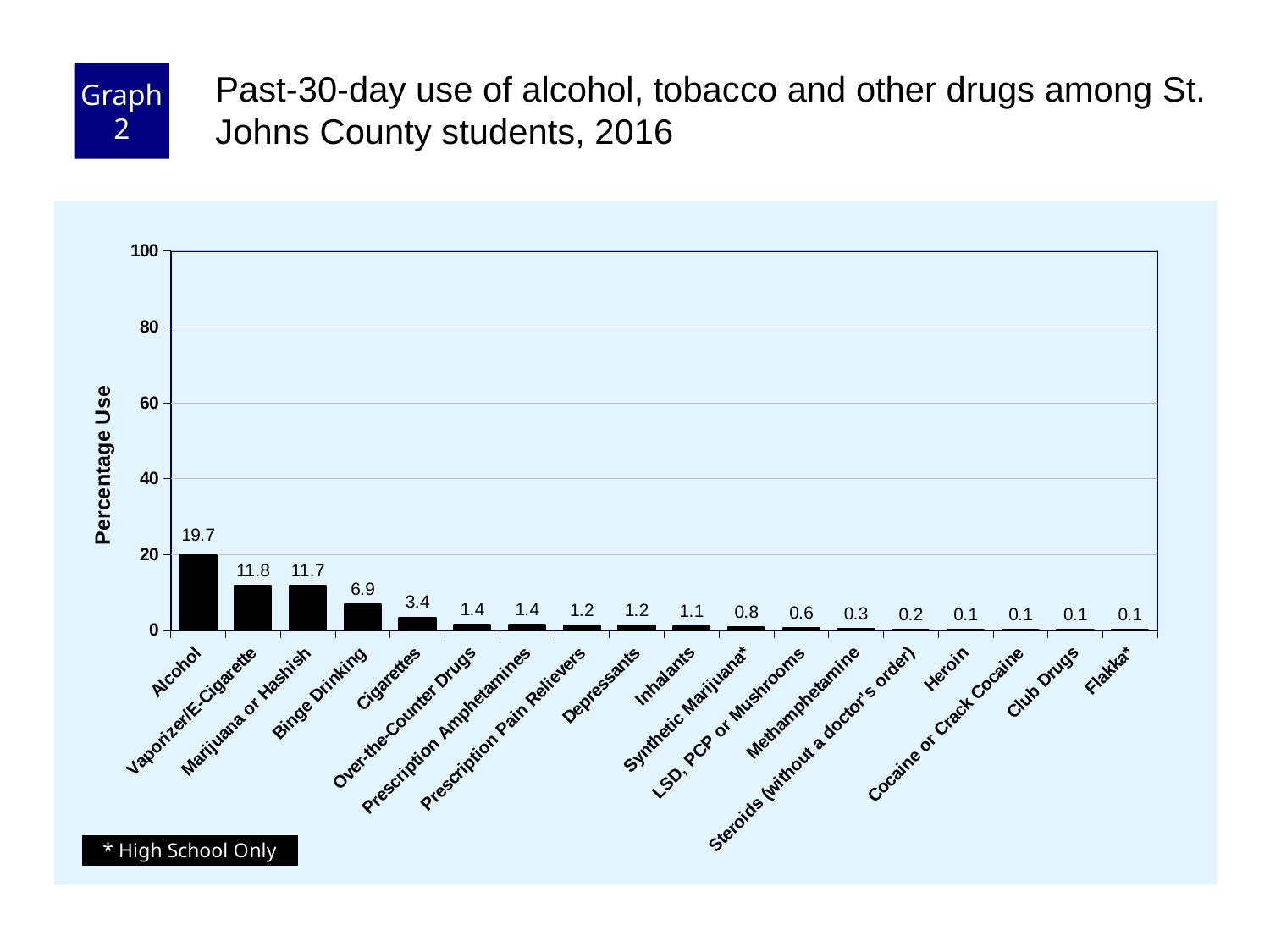
What is the percentage use for Synthetic Marijuana? 0.8 What is the difference in percentage use between Binge Drinking and Cigarettes? 3.5 What type of chart is shown on the slide? Bar chart What is the percentage use for Cigarettes? 3.4 Which category has the highest percentage use? Alcohol What is the percentage use for Alcohol? 19.7 What is the lowest percentage use value shown on the chart? 0.1 What is the percentage use for Binge Drinking? 6.9 What is the difference in percentage use between Alcohol and Vaporizer/E-Cigarette? 7.9 Is the value for Alcohol greater or less than 20? less How many categories are shown on the chart? 18 Which has a higher percentage use, Marijuana or Hashish or Binge Drinking? Marijuana or Hashish